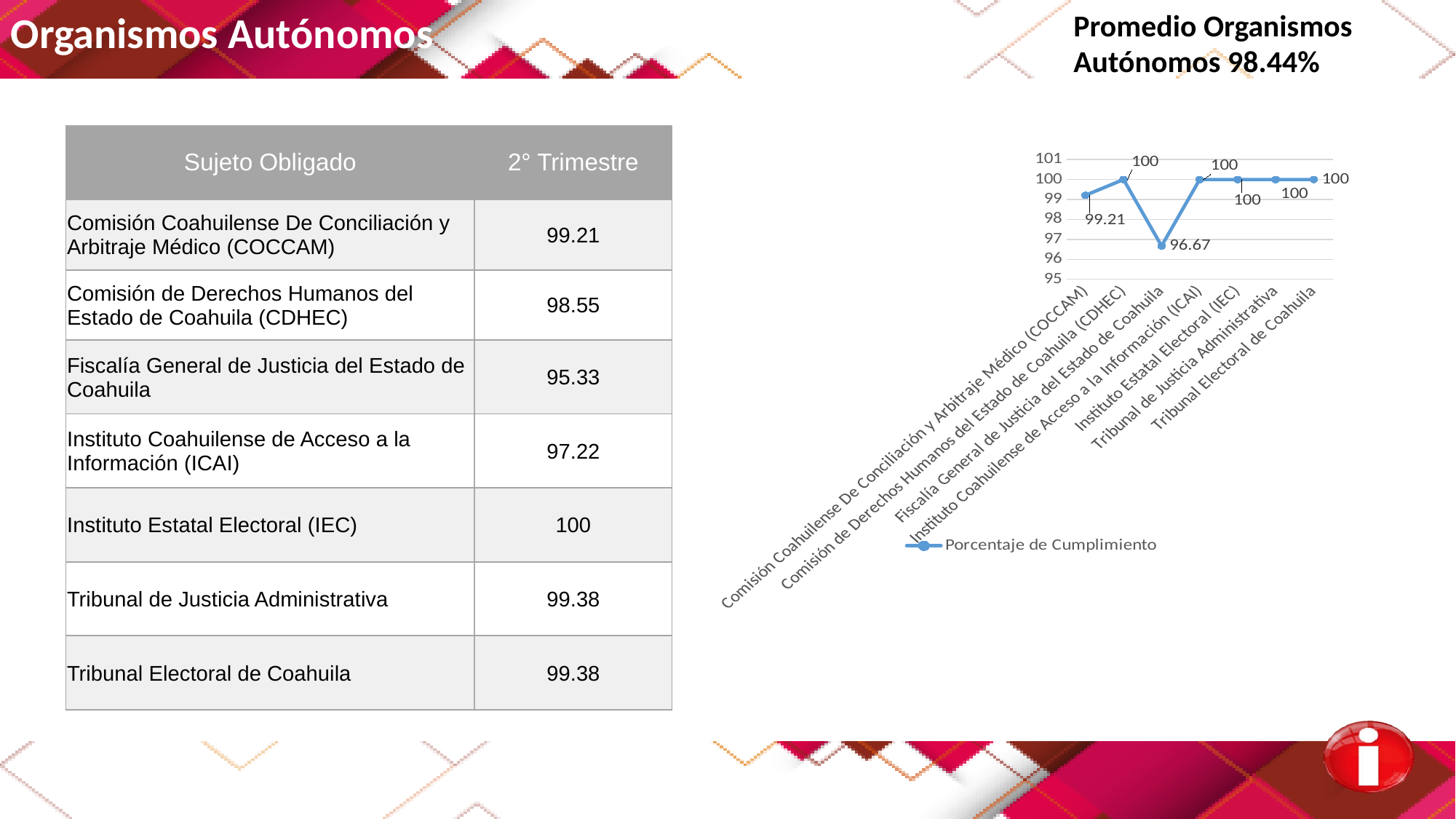
What kind of chart is shown on the slide? line chart How many series does the chart legend list? 1 In the chart, which is larger: the value for Tribunal Electoral de Coahuila or the value for Comisión Coahuilense De Conciliación y Arbitraje Médico (COCCAM)? Tribunal Electoral de Coahuila How many data points (organisms) are plotted in the chart? 7 In the chart, what is the value for Fiscalía General de Justicia del Estado de Coahuila? 96.67 In the chart, what is the difference between the value for Comisión Coahuilense De Conciliación y Arbitraje Médico (COCCAM) and the value for Fiscalía General de Justicia del Estado de Coahuila? 2.54 In the chart, what is the difference between the value for Instituto Coahuilense de Acceso a la Información (ICAI) and the value for Fiscalía General de Justicia del Estado de Coahuila? 3.33 In the chart, what is the value for Comisión Coahuilense De Conciliación y Arbitraje Médico (COCCAM)? 99.21 In the chart, what is the value for Instituto Estatal Electoral (IEC)? 100 What is the name of the series shown in the chart legend? Porcentaje de Cumplimiento In the chart, is the value for Fiscalía General de Justicia del Estado de Coahuila greater or less than 97? less Which category has the lowest value in the chart? Fiscalía General de Justicia del Estado de Coahuila